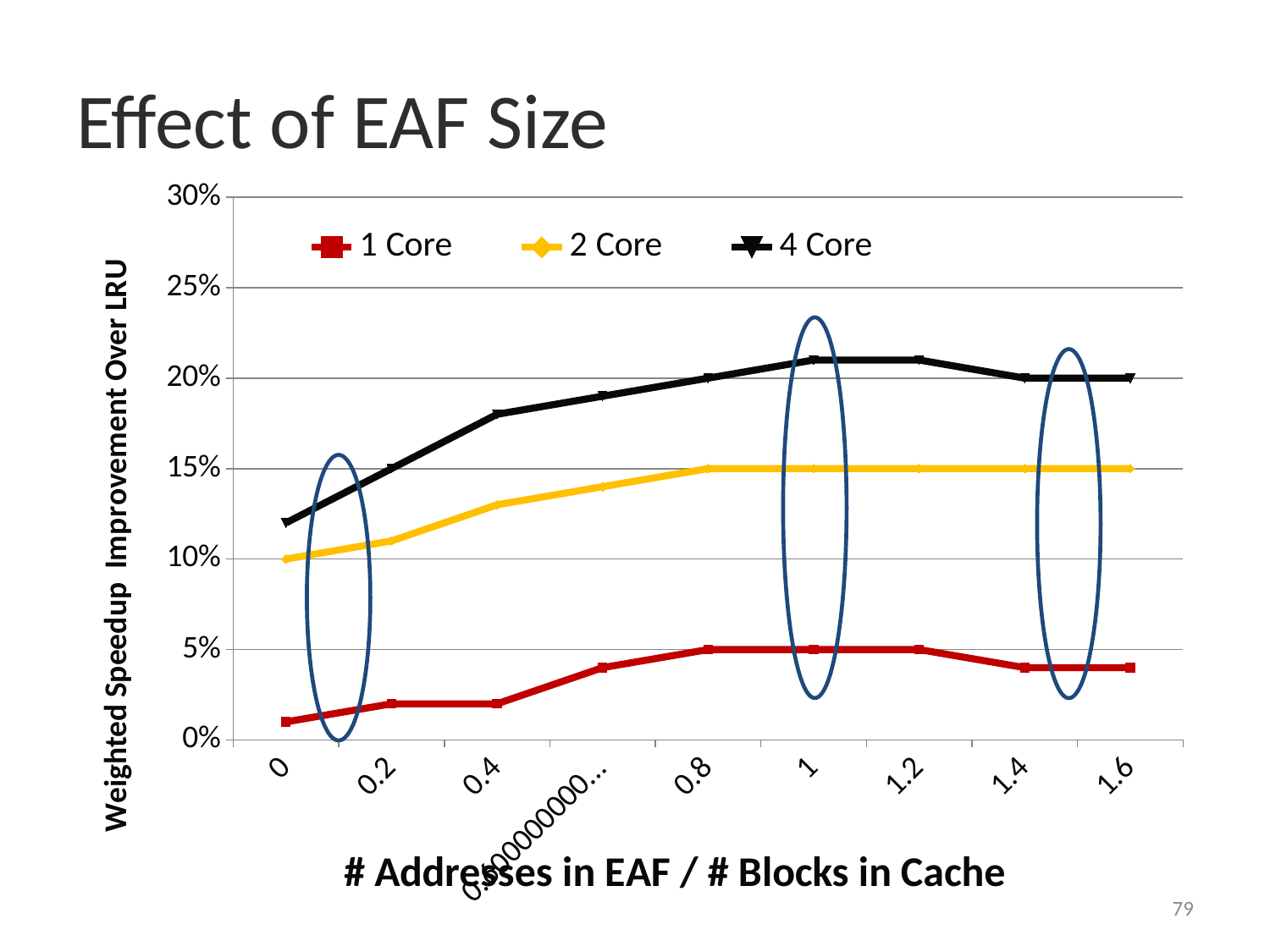
How many series does the legend list? 3 What is the label of the x axis? # Addresses in EAF / # Blocks in Cache What is the value for 1 Core at x = 1? 5% What is the value for 2 Core at x = 1.6? 15% Which series has the lowest values across the x axis? 1 Core What kind of chart is shown on the slide? line chart Which series has the highest values across the x axis? 4 Core What is the title of the chart? Effect of EAF Size Is the value for 4 Core at x = 1 greater or less than 20%? greater Is the value for 1 Core at x = 0 greater or less than 5%? less What is the value for 4 Core at x = 0.8? 20% What is the value for 2 Core at x = 0? 10%